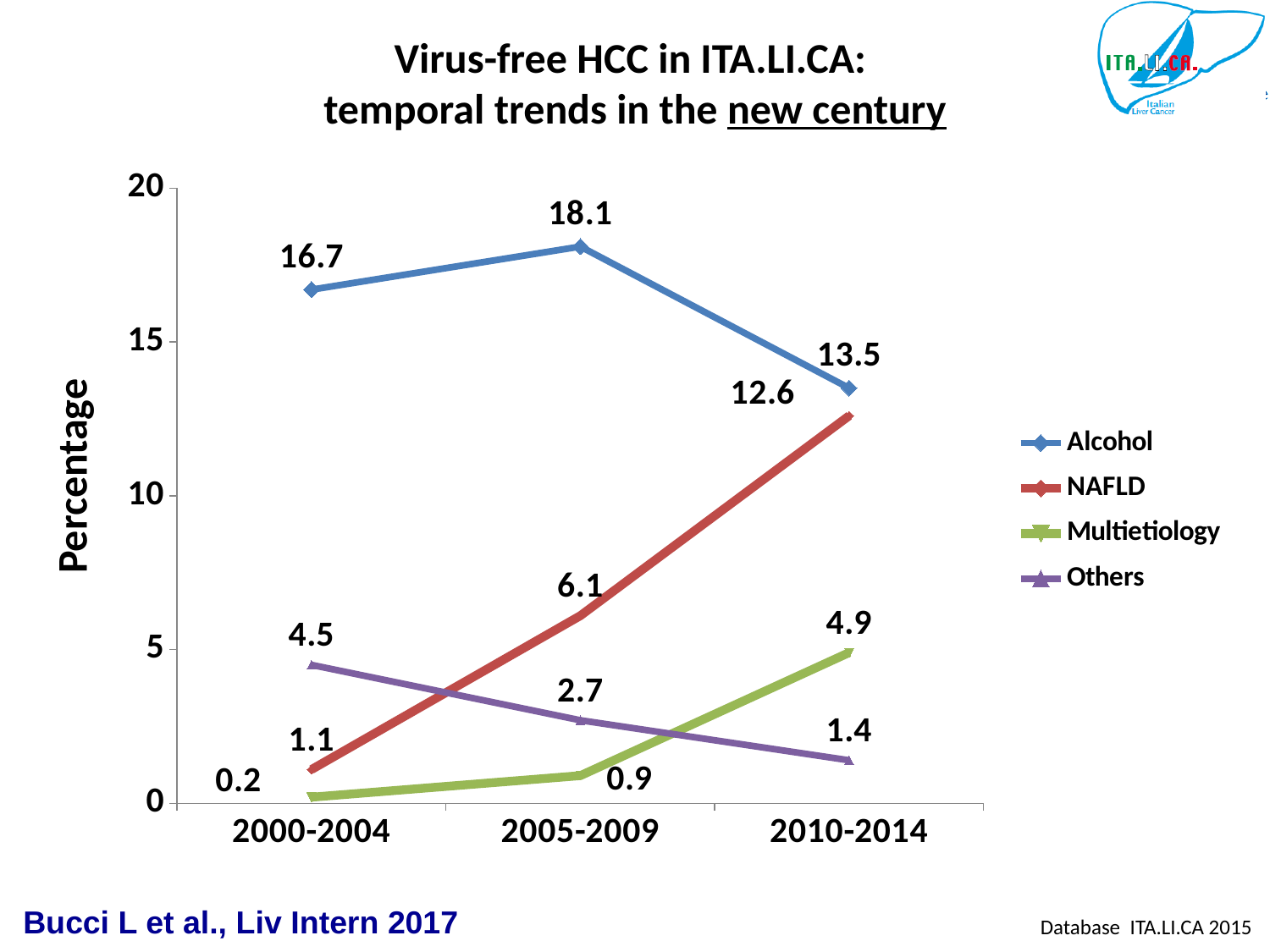
In which period is the Others percentage lowest? 2010-2014 What is the Alcohol percentage for 2005-2009? 18.1 What is the Multietiology percentage for 2000-2004? 0.2 What is the NAFLD percentage for 2010-2014? 12.6 What is the Others percentage for 2005-2009? 2.7 How many time periods are shown on the x axis? 3 What kind of chart is shown on the slide? Line chart What is the difference between the NAFLD percentage in 2010-2014 and in 2000-2004? 11.5 Does the NAFLD percentage rise or fall from 2000-2004 to 2010-2014? Rise In which period is the Alcohol percentage highest? 2005-2009 Which is larger in 2010-2014, the Alcohol percentage or the NAFLD percentage? Alcohol How many series does the legend list? 4